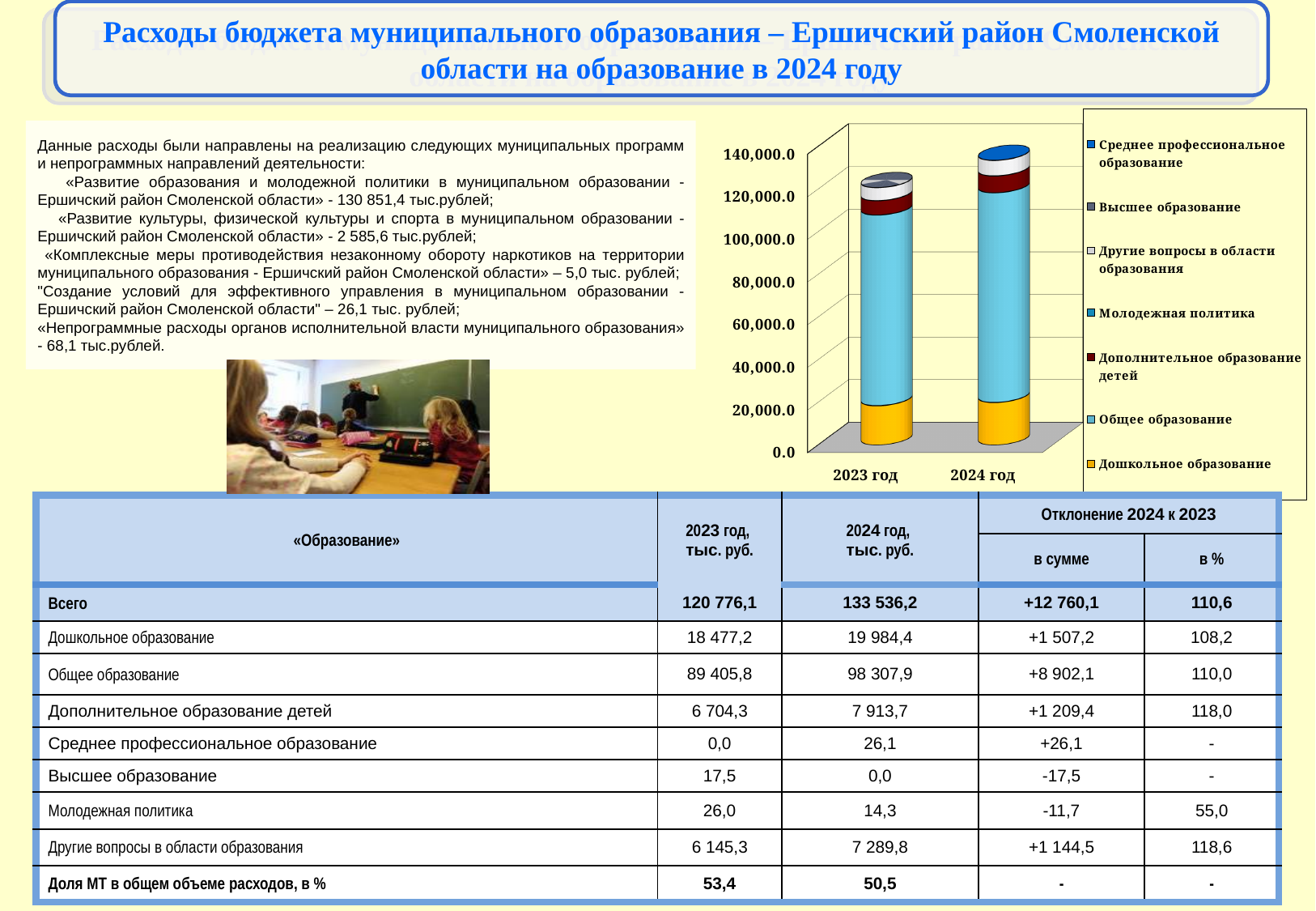
How many categories (years) are shown on the x axis of the chart? 2 Which series is listed last (at the bottom) in the chart legend? Дошкольное образование Which year has the taller stacked bar, 2023 год or 2024 год? 2024 год Is the total height of the 2023 год bar greater or less than 100,000.0? greater How many series does the chart legend list? 7 What kind of chart is shown on the slide? bar chart Do the total bar heights rise or fall from 2023 год to 2024 год? rise Is the total height of the 2024 год bar greater or less than 120,000.0? greater What colour is used for the Дошкольное образование series in the chart? yellow Which series occupies the largest segment of each stacked bar? Общее образование